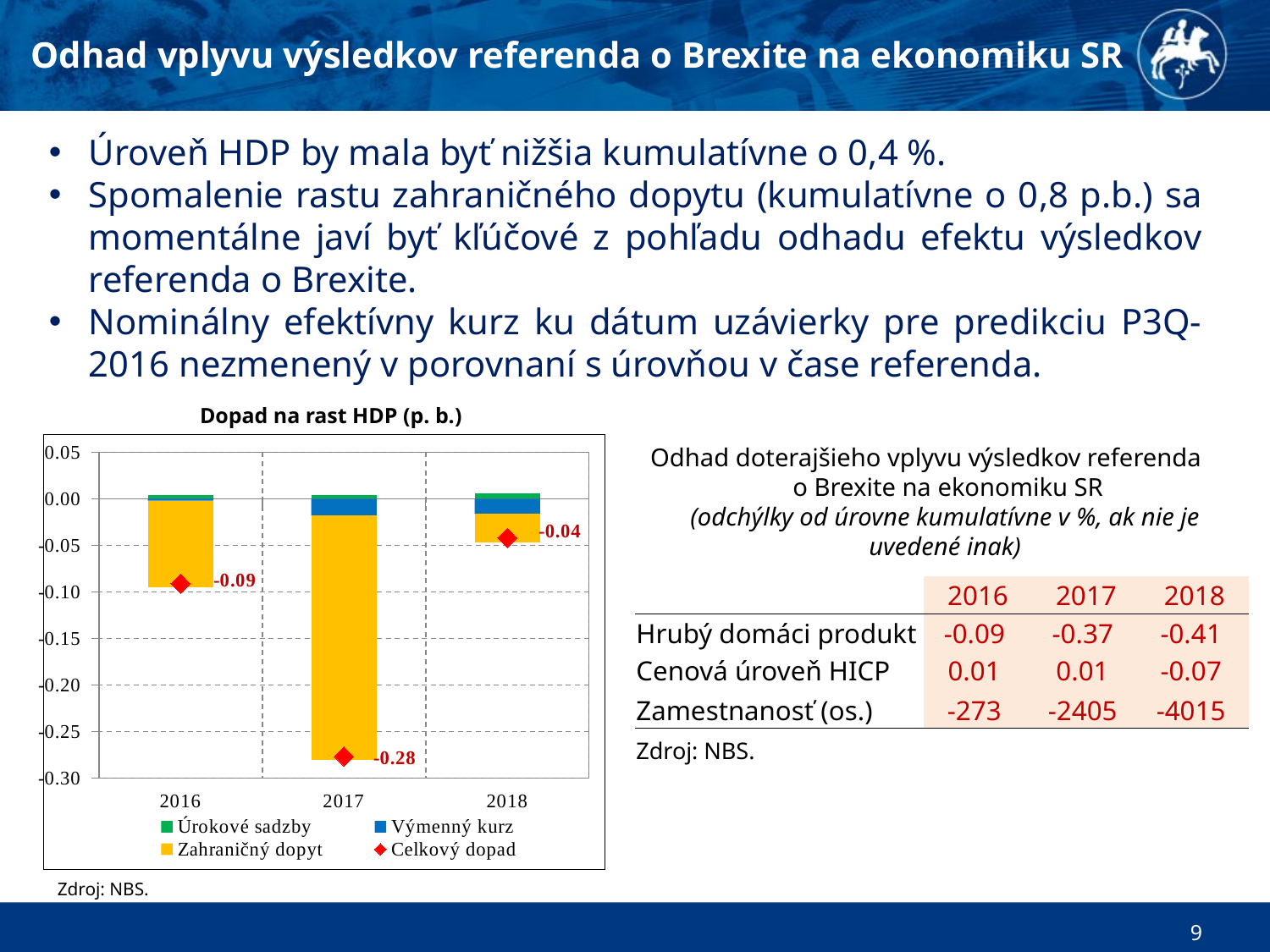
Which year has the highest (least negative) Celkový dopad value in the chart? 2018 What kind of chart is 'Dopad na rast HDP (p. b.)'? bar chart Is the Celkový dopad value for 2016 or for 2018 larger? 2018 What is the value of Celkový dopad for 2017 in the chart? -0.28 Which year has the lowest (most negative) Celkový dopad value in the chart? 2017 Which colour represents Zahraničný dopyt in the chart? yellow By how much does the Celkový dopad value for 2017 differ from the value for 2016? 0.19 How many years are shown on the x axis of the chart? 3 What is the value of Celkový dopad for 2018 in the chart? -0.04 How many entries does the chart legend list? 4 What is the value of Celkový dopad for 2016 in the chart 'Dopad na rast HDP (p. b.)'? -0.09 Is the Zahraničný dopyt bar for 2017 greater or less than -0.25? less